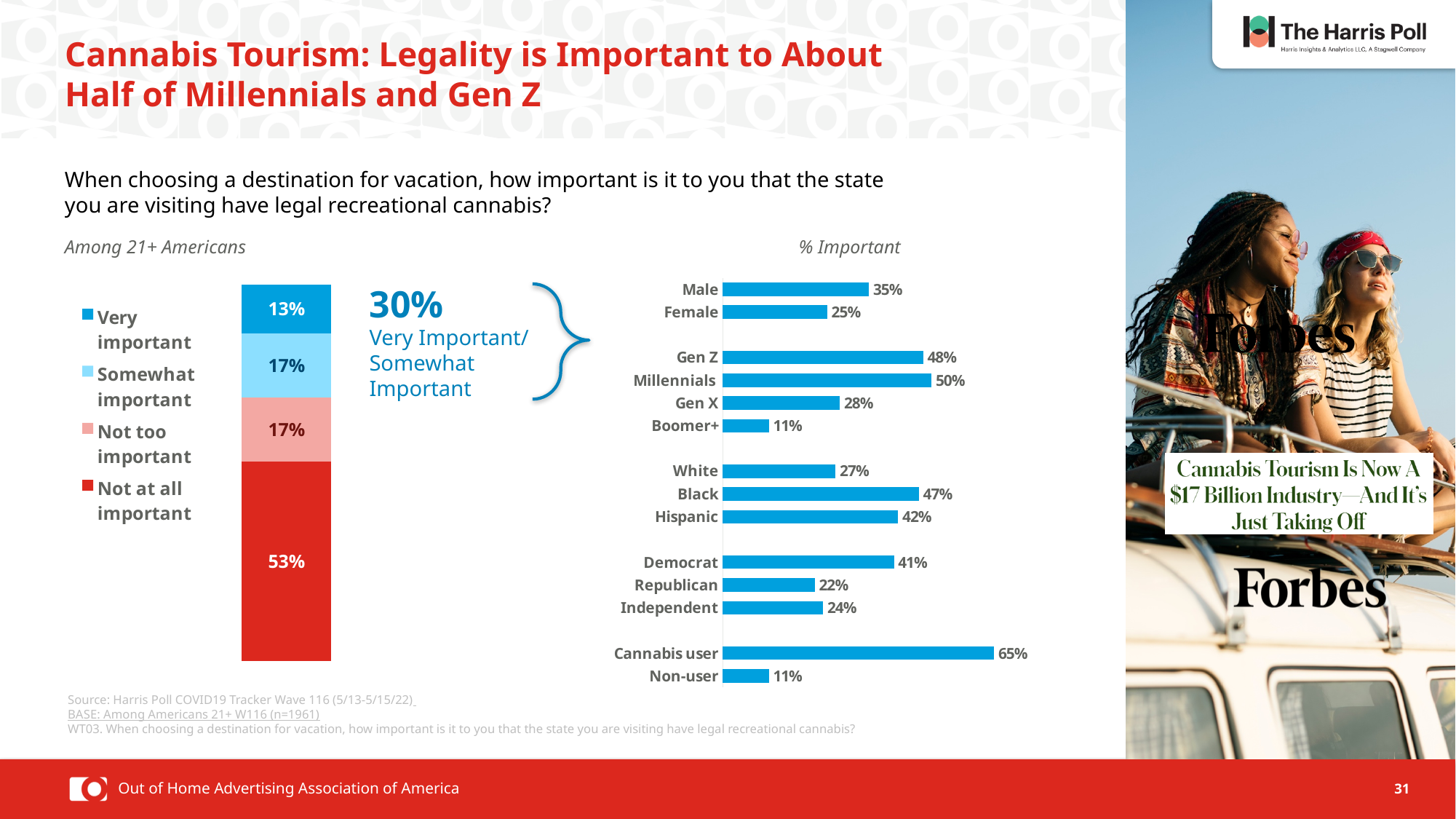
In the '% Important' bar chart, which is larger, Democrat or Republican? Democrat In the stacked bar chart 'Among 21+ Americans', what share is 'Very important'? 13% In the stacked bar chart 'Among 21+ Americans', what is the combined share of 'Very important' and 'Somewhat important'? 30% In the stacked bar chart 'Among 21+ Americans', what share is 'Not at all important'? 53% In the '% Important' bar chart, what is the difference between Gen Z and Boomer+? 37% What kind of chart is the '% Important' chart on the right? Bar chart In the stacked bar chart 'Among 21+ Americans', how many series does the legend list? 4 In the '% Important' bar chart, what is the value for Millennials? 50% In the '% Important' bar chart, what is the value for Cannabis user? 65% In the '% Important' bar chart, which category has the highest value? Cannabis user In the '% Important' bar chart, what is the difference between Male and Female? 10% In the '% Important' bar chart, how many categories are plotted? 14